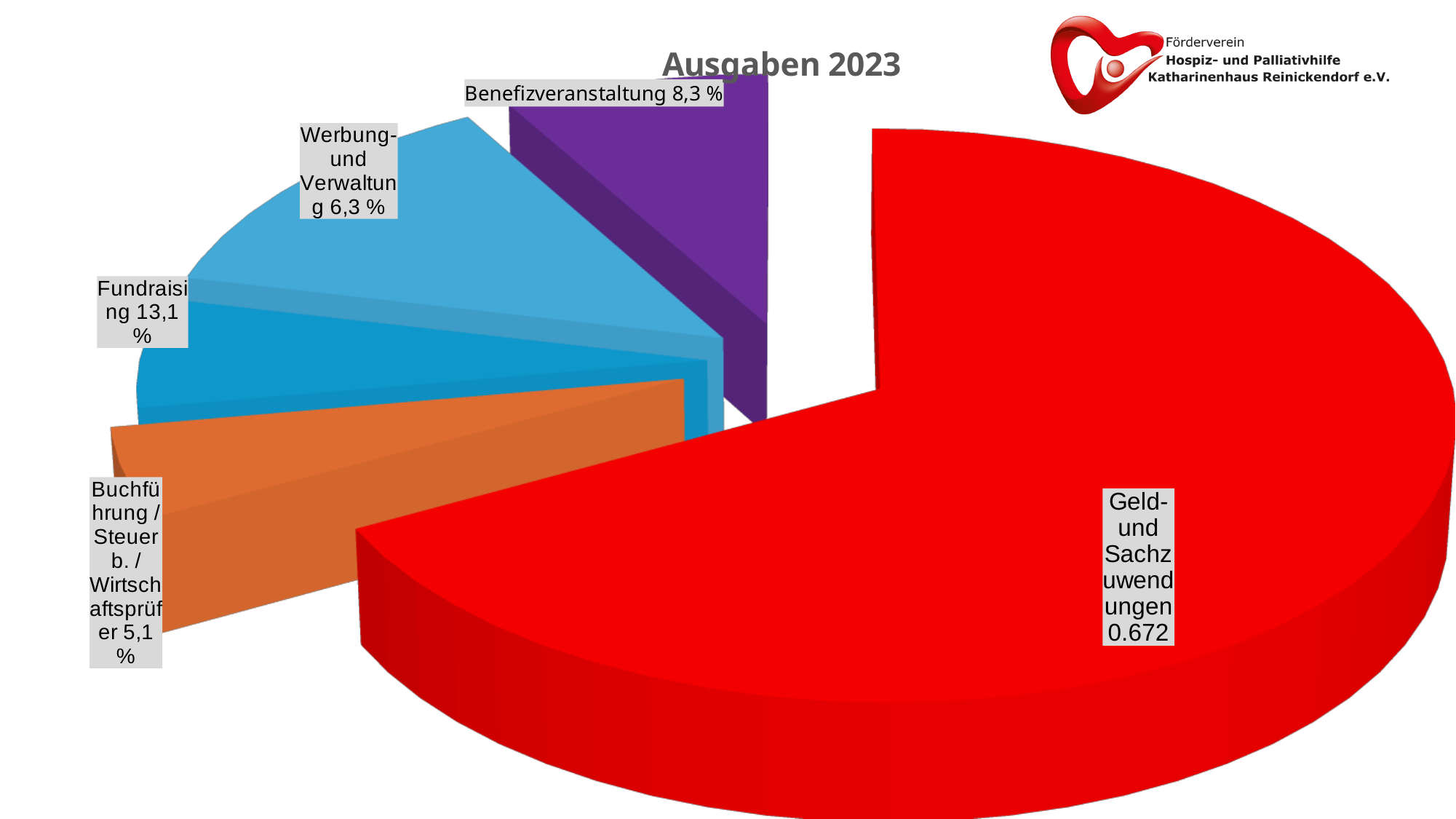
Which category has the smallest slice of the pie? Buchführung / Steuerb. / Wirtschaftsprüfer What value is printed on the Geld- und Sachzuwendungen slice? 0.672 Which category has the largest slice of the pie? Geld- und Sachzuwendungen What value is shown for Benefizveranstaltung? 8,3 % What value is shown for Fundraising? 13,1 % How many slices does the pie chart have? 5 What is the difference between the Fundraising and Benefizveranstaltung percentages? 4,8 % What type of chart is shown on the slide? Pie chart What value is shown for Werbung- und Verwaltung? 6,3 % What is the title of the chart? Ausgaben 2023 What value is shown for Buchführung / Steuerb. / Wirtschaftsprüfer? 5,1 %